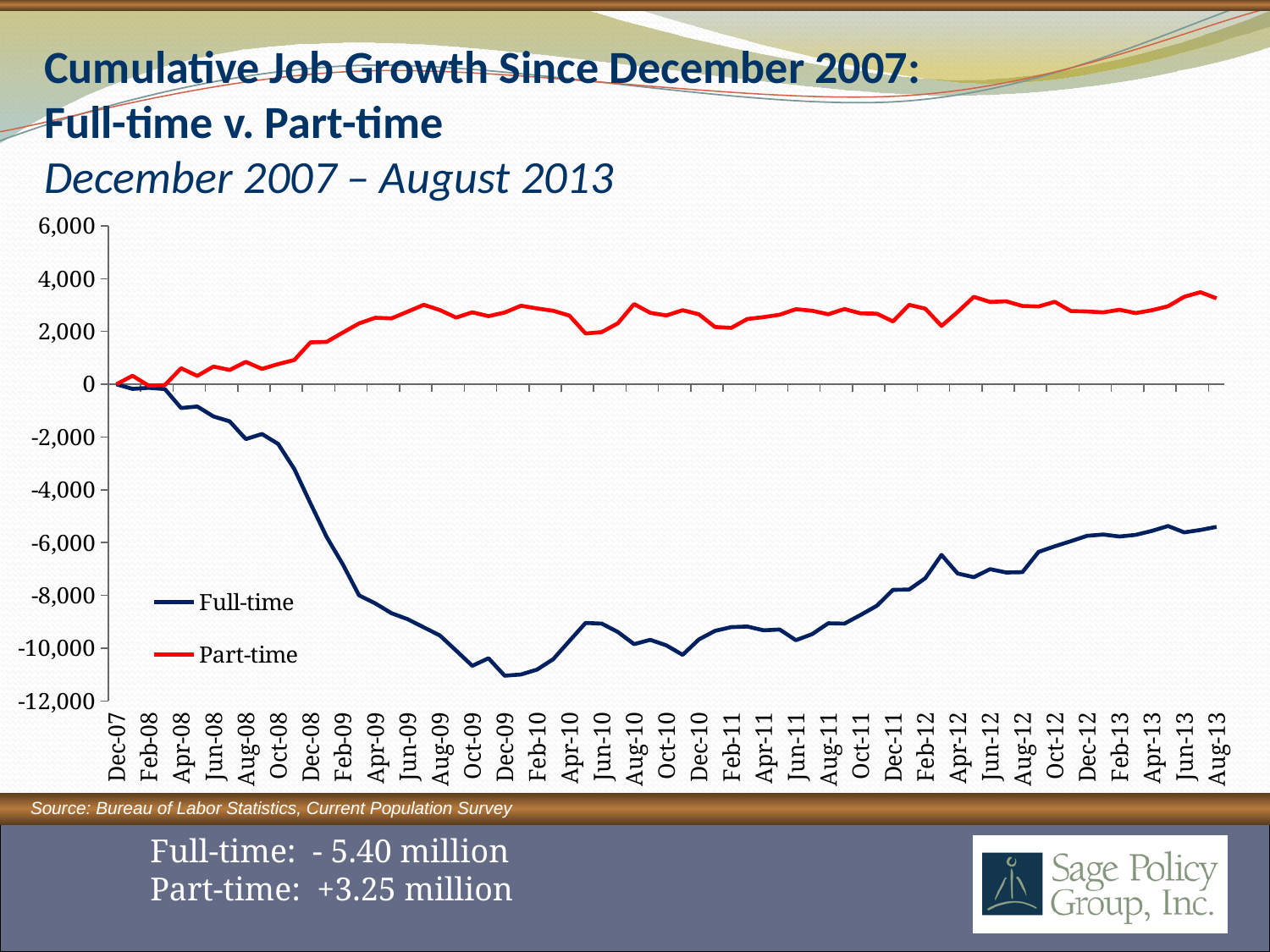
Is the Full-time value at Dec-09 greater or less than -10,000? less According to the text below the chart, what is the cumulative part-time job growth as of August 2013? +3.25 million Is the Part-time value at Aug-13 greater or less than 2,000? greater Does the Full-time series rise or fall between Dec-07 and Dec-09? fall What kind of chart is shown on the slide? line chart Is the Full-time value at Jun-10 greater or less than -8,000? less How many series does the chart's legend list? 2 At Aug-13, which series has the higher value, Full-time or Part-time? Part-time What are the two series named in the chart's legend? Full-time and Part-time What is the title of the chart on the slide? Cumulative Job Growth Since December 2007: Full-time v. Part-time According to the text below the chart, what is the cumulative full-time job growth as of August 2013? -5.40 million